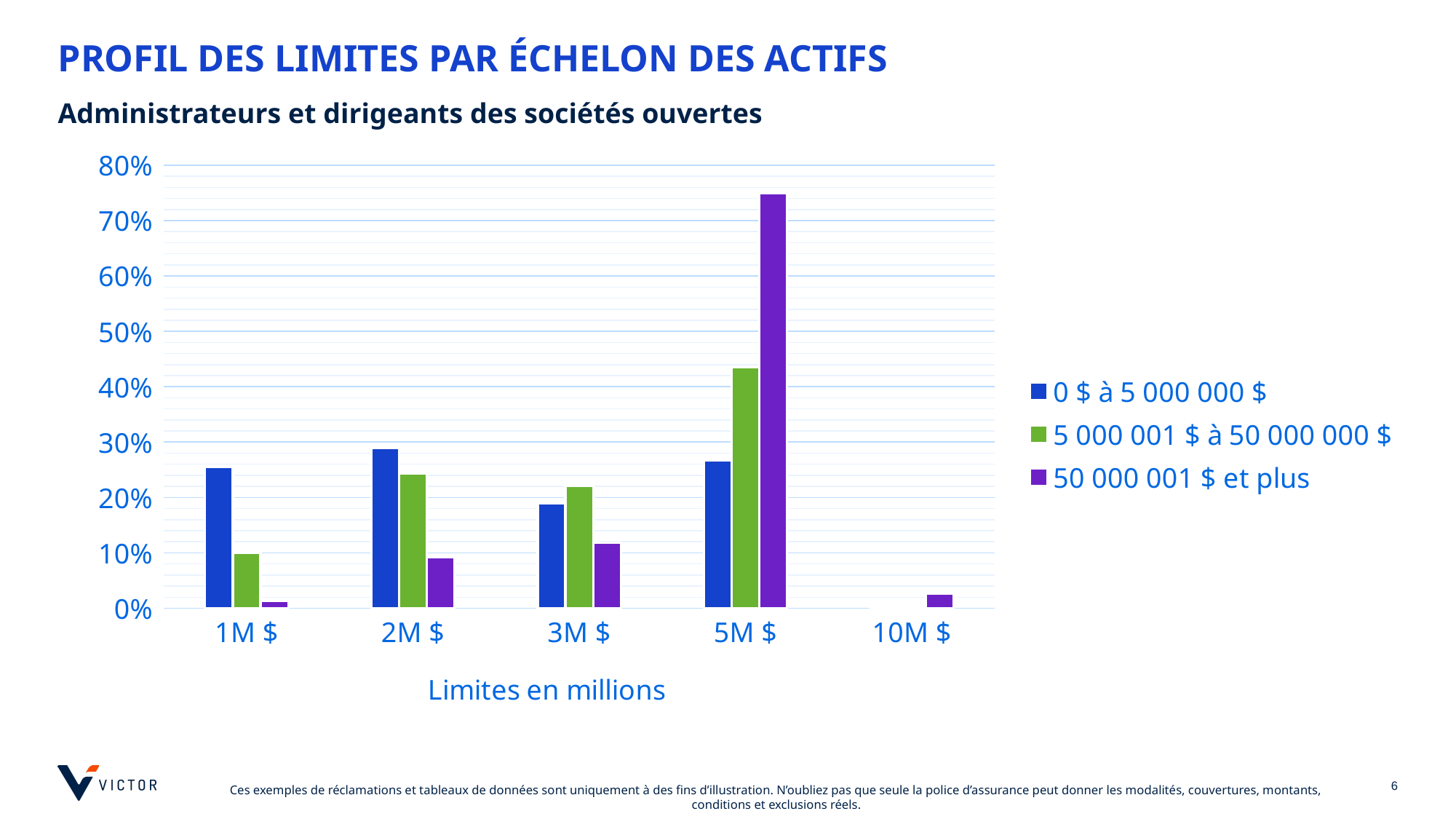
For the series "50 000 001 $ et plus", which limit has the highest value? 5M $ How many series does the legend list? 3 Is the value for "5 000 001 $ à 50 000 000 $" at 2M $ greater or less than 20%? greater For the series "5 000 001 $ à 50 000 000 $", which limit has the highest value? 5M $ At 5M $, which series has the larger value: "5 000 001 $ à 50 000 000 $" or "50 000 001 $ et plus"? 50 000 001 $ et plus How many limit categories are shown on the x axis? 5 At 1M $, which series has the larger value: "0 $ à 5 000 000 $" or "5 000 001 $ à 50 000 000 $"? 0 $ à 5 000 000 $ Is the value for "5 000 001 $ à 50 000 000 $" at 5M $ greater or less than 40%? greater What is the title of the x axis? Limites en millions What kind of chart is shown on the slide? Bar chart Is the value for "0 $ à 5 000 000 $" at 1M $ greater or less than 20%? greater